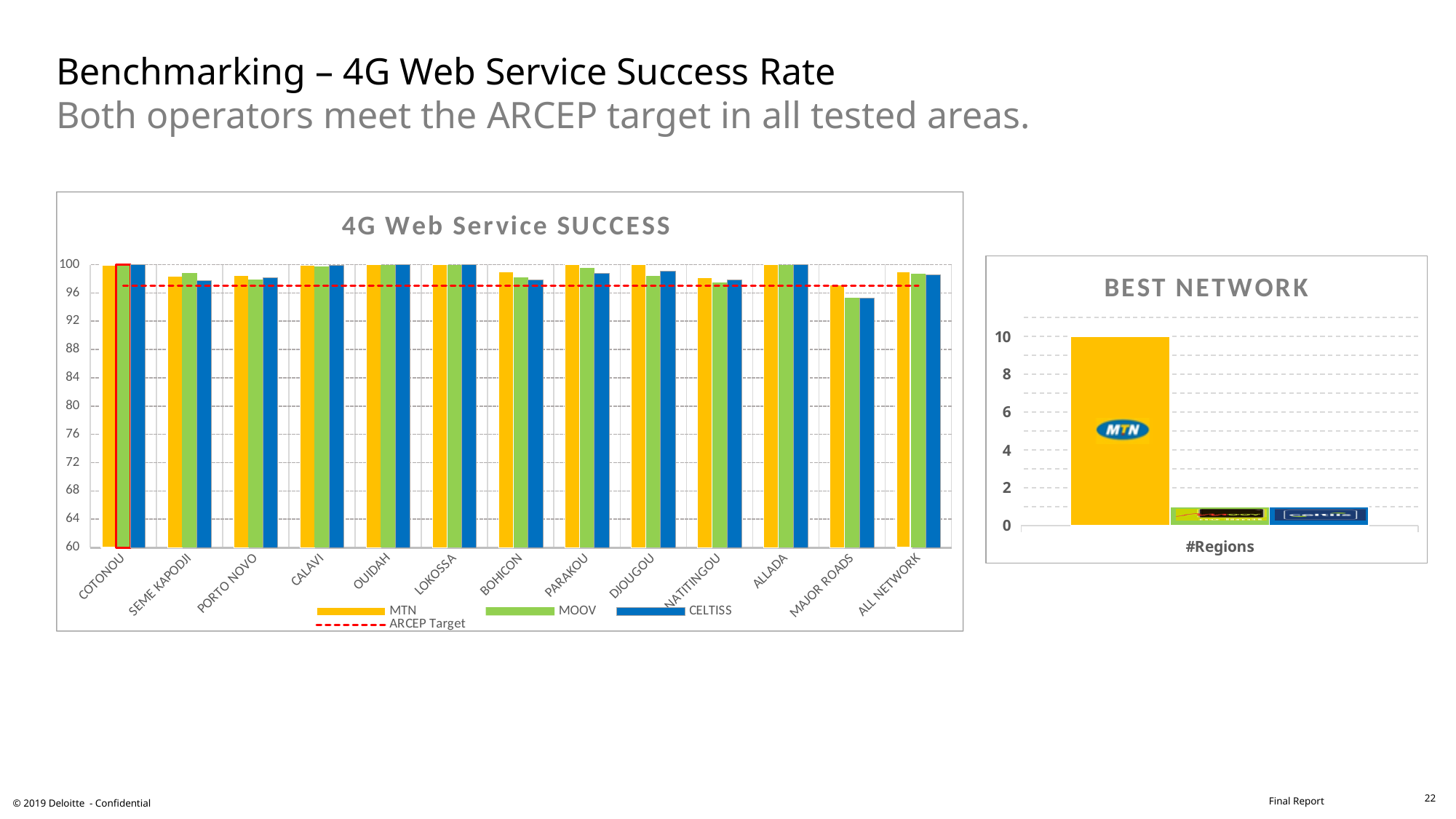
How many categories are shown on the x axis of the '4G Web Service SUCCESS' chart? 13 What is the title of the chart on the left of the slide? 4G Web Service SUCCESS What kind of chart is the '4G Web Service SUCCESS' chart? bar chart What is the x-axis label of the 'BEST NETWORK' chart? #Regions In the 'BEST NETWORK' chart, what is the value of the MTN bar? 10 In the 'BEST NETWORK' chart, which operator has the highest bar? MTN How many entries does the legend of the '4G Web Service SUCCESS' chart list? 4 In the 'BEST NETWORK' chart, is the value for MOOV greater or less than 2? less In the '4G Web Service SUCCESS' chart, which category has the lowest MOOV value? MAJOR ROADS In the '4G Web Service SUCCESS' chart, which is larger for MAJOR ROADS: the MTN value or the MOOV value? MTN In the '4G Web Service SUCCESS' chart, is the MOOV value for MAJOR ROADS greater or less than 96? less In the '4G Web Service SUCCESS' chart, is the CELTISS value for ALLADA greater or less than 96? greater